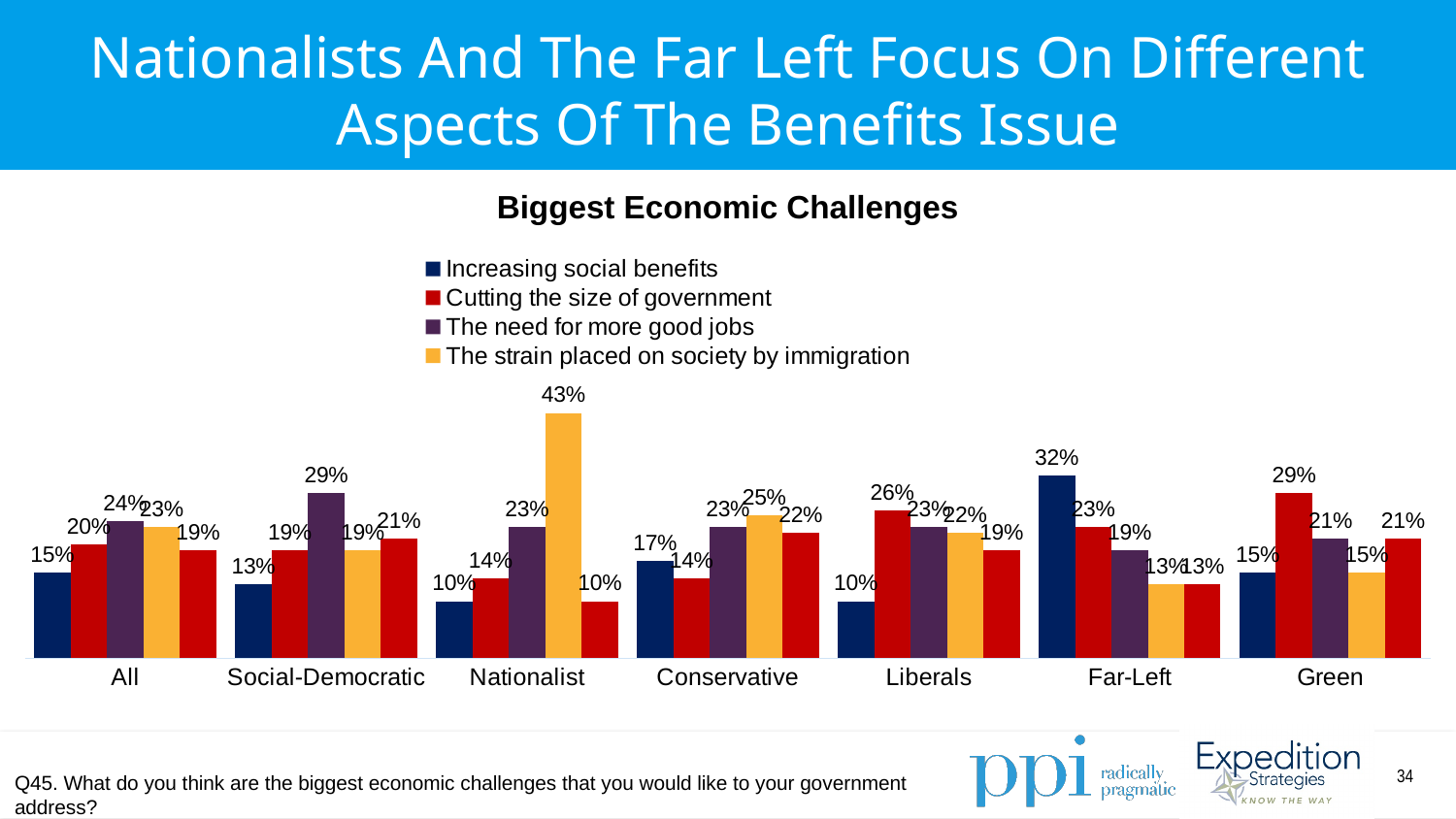
Which category has the lowest value for 'The strain placed on society by immigration'? Far-Left What is the value for 'Cutting the size of government' among Greens? 29% What is the value for 'Increasing social benefits' among the Far-Left? 32% How many series does the chart's legend list? 4 How many categories are shown along the x axis of the chart? 7 What is the title of the chart? Biggest Economic Challenges What kind of chart is shown on the slide? Bar chart What is the difference between the Nationalist and Far-Left values for 'The strain placed on society by immigration'? 30 percentage points What is the value for 'The strain placed on society by immigration' among Nationalists? 43% Which category has the highest value for 'Increasing social benefits'? Far-Left What is the value for 'Cutting the size of government' among Liberals? 26% Which category has the highest value for 'The strain placed on society by immigration'? Nationalist